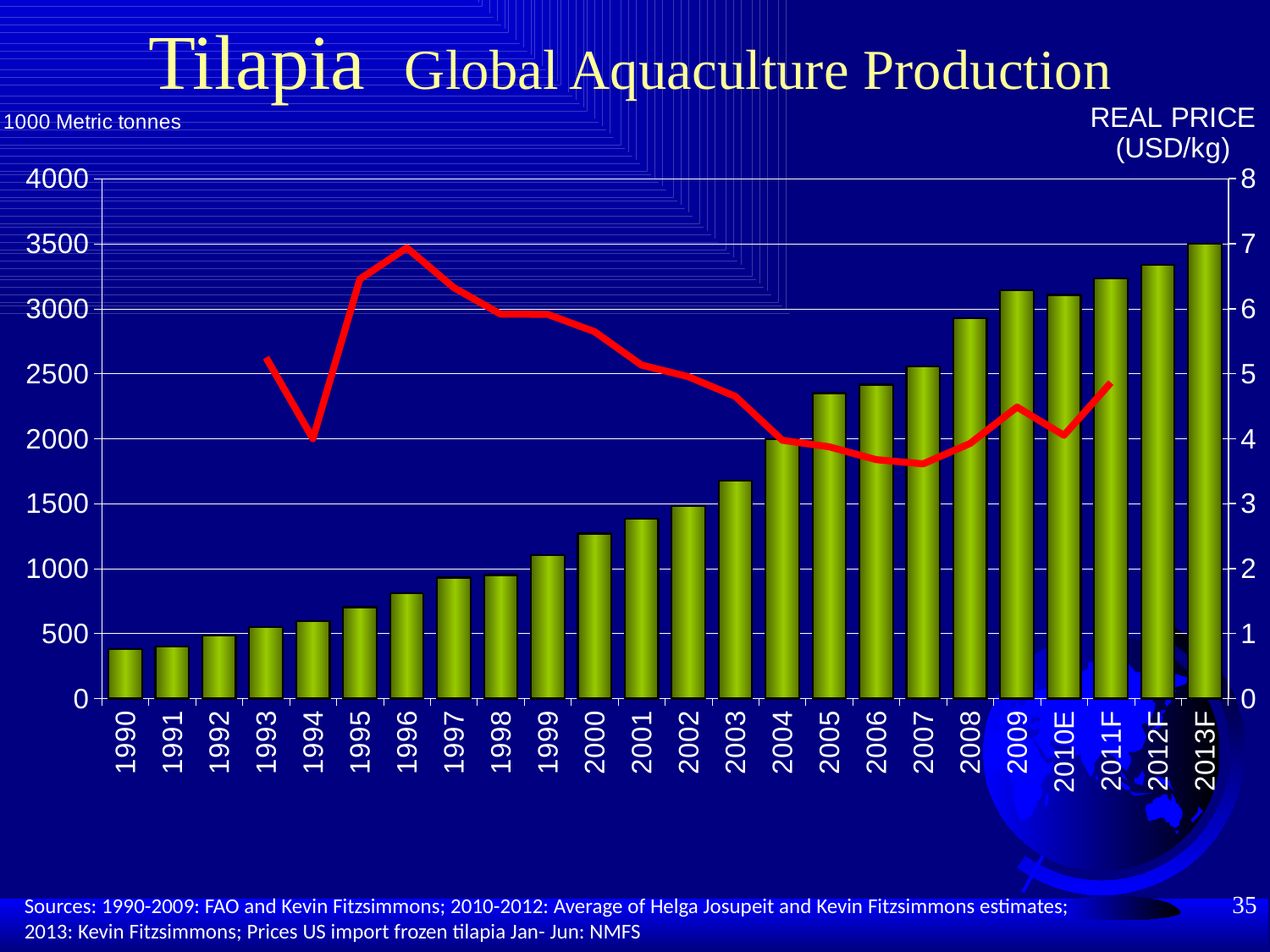
What kind of chart is used to show the production values? Bar chart (with a line for real price) Is the production value for 2000 greater or less than 1000? greater Which year has the tallest production bar? 2013F In which year does the real price line reach its highest point? 1996 Which is larger, the production bar for 2005 or for 2004? 2005 Do the production bars generally rise or fall from 1990 to 2013F? rise Is the production value for 2003 greater or less than 1500? greater Is the production value for 1998 greater or less than 1000? less What unit is given for the left-hand axis? 1000 Metric tonnes How many years (categories) are shown on the x axis? 24